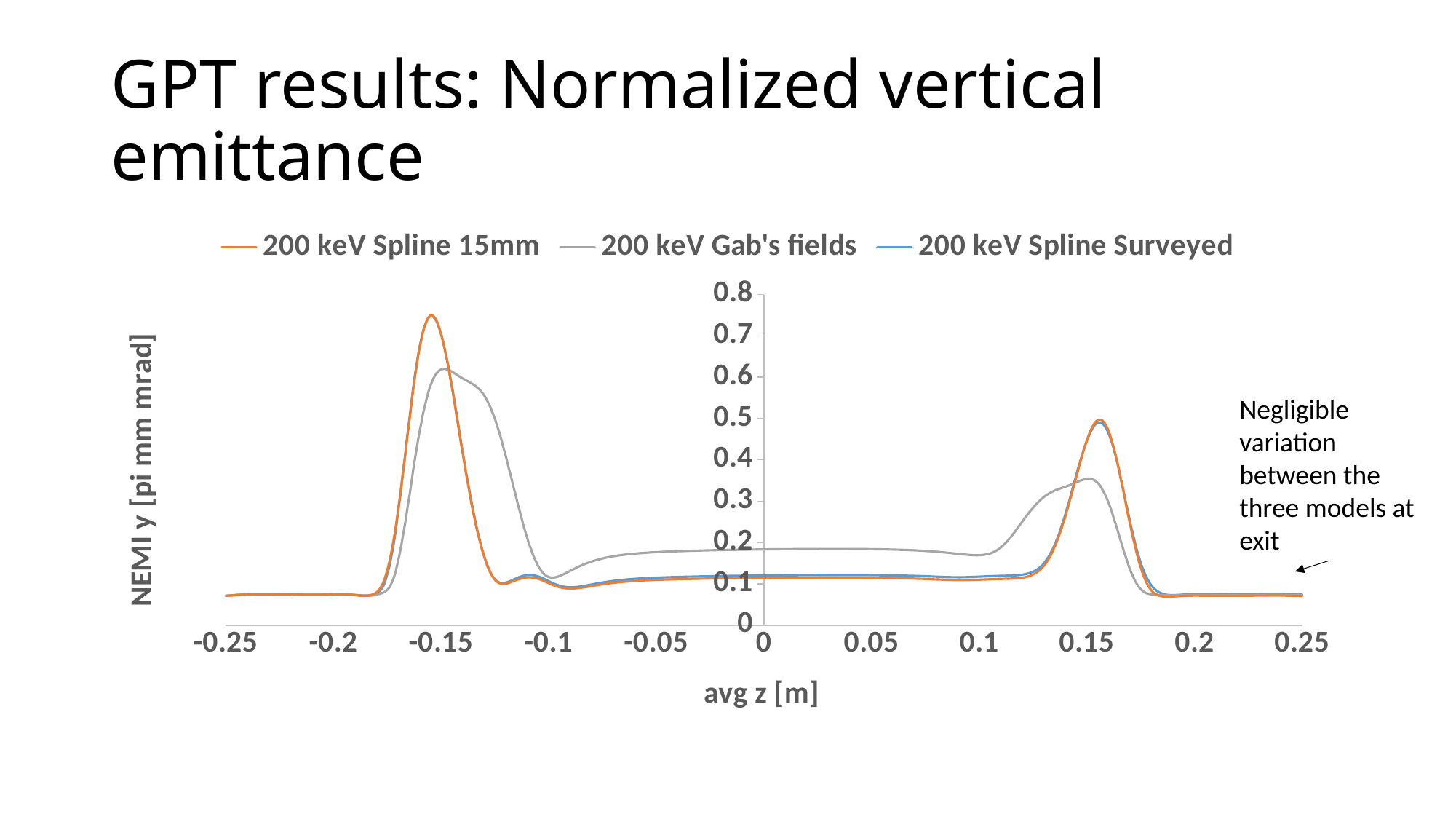
How many series does the legend list? 3 What are the three series named in the legend? 200 keV Spline 15mm, 200 keV Gab's fields, 200 keV Spline Surveyed Is the value of the 200 keV Gab's fields series at avg z = 0 greater or less than 0.1? greater Near avg z = -0.15 m, which series reaches a higher peak: 200 keV Spline 15mm or 200 keV Gab's fields? 200 keV Spline 15mm What kind of chart is shown on the slide? line chart Is the peak value of the 200 keV Spline 15mm series near avg z = -0.15 m greater or less than 0.7? greater Is the peak value of the 200 keV Gab's fields series near avg z = 0.15 m greater or less than 0.4? less At avg z = 0, which series has the higher value: 200 keV Gab's fields or 200 keV Spline 15mm? 200 keV Gab's fields What is the label of the vertical axis? NEMI y [pi mm mrad] Near avg z = 0.15 m, which series reaches a higher peak: 200 keV Gab's fields or 200 keV Spline Surveyed? 200 keV Spline Surveyed